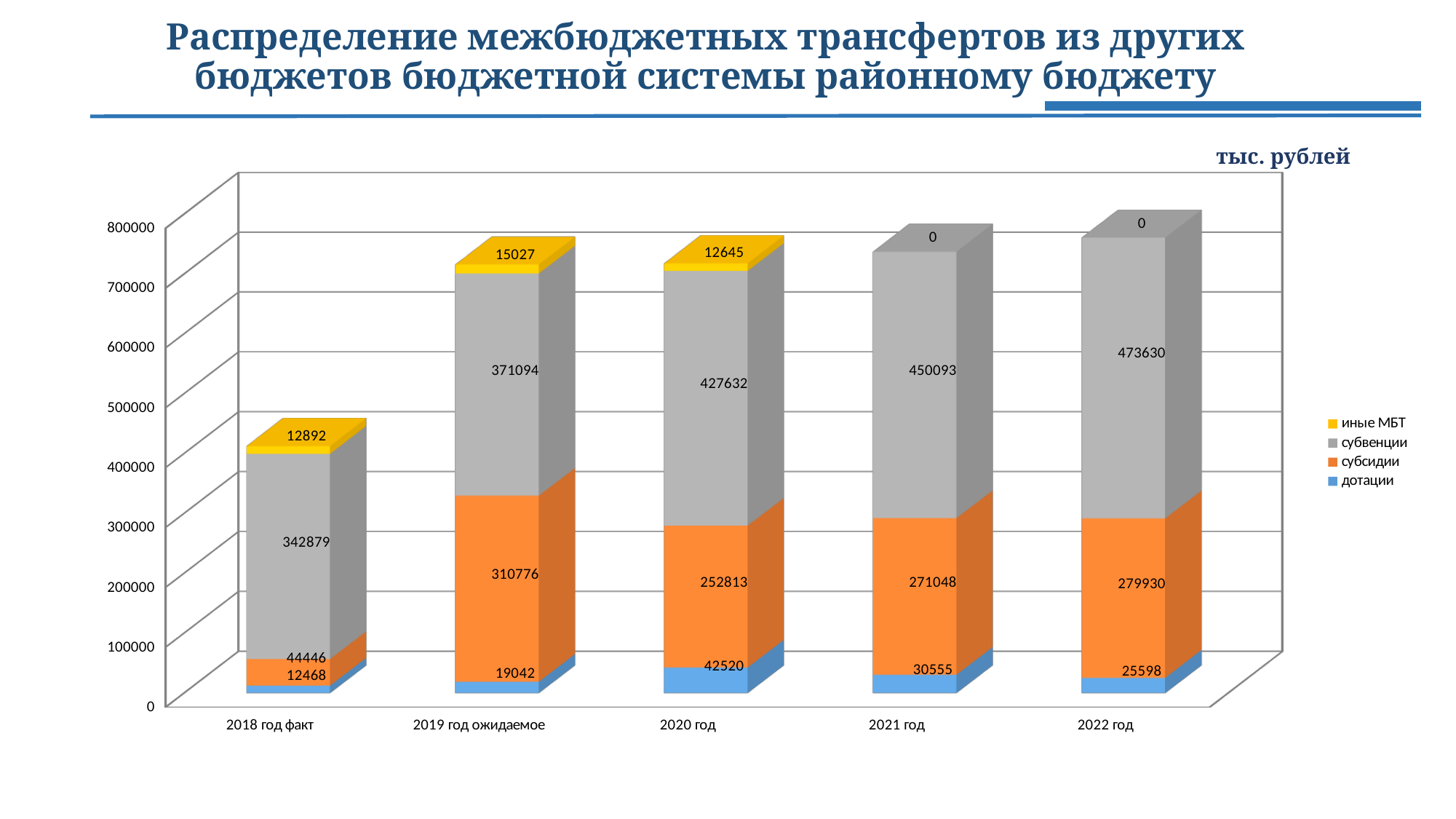
What is the value of дотации for 2018 год факт? 12468 How many categories (years) are shown on the x axis? 5 Which is larger: субсидии in 2019 год ожидаемое or in 2020 год? 2019 год ожидаемое What is the value of иные МБТ for 2019 год ожидаемое? 15027 How many series does the legend list? 4 What is the value of субвенции for 2020 год? 427632 Which year has the lowest value for субсидии? 2018 год факт Which year has the highest value for субвенции? 2022 год What unit is stated above the chart? тыс. рублей What is the difference between субвенции in 2022 год and in 2018 год факт? 130751 What type of chart is shown on the slide? stacked bar chart What is the total of the stacked bar for 2021 год? 751696